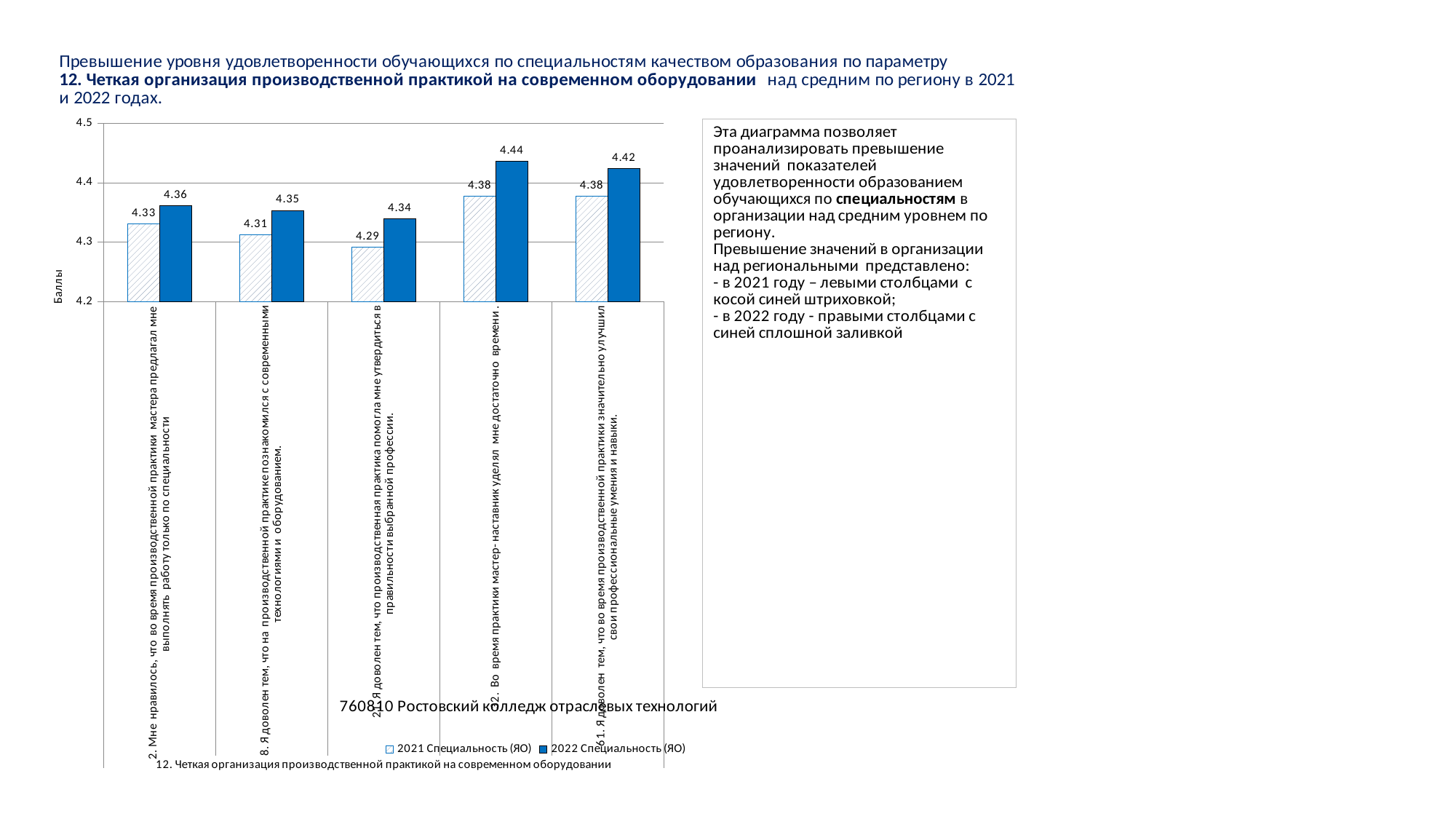
What is the 2022 Специальность (ЯО) value for statement 61 ("Я доволен тем, что во время производственной практики значительно улучшил свои профессиональные умения и навыки")? 4.42 What type of chart is shown on the slide? Bar chart Which statement has the lowest 2021 Специальность (ЯО) value? 21. Я доволен тем, что производственная практика помогла мне утвердиться в правильности выбранной профессии What is the 2021 Специальность (ЯО) value for statement 2 ("Мне нравилось, что во время производственной практики мастер предлагал мне выполнять работу только по специальности")? 4.33 What is the 2022 Специальность (ЯО) value for statement 32 ("Во время практики мастер-наставник уделял мне достаточно времени")? 4.44 Which statement has the highest 2022 Специальность (ЯО) value? 32. Во время практики мастер-наставник уделял мне достаточно времени For statement 8 ("Я доволен тем, что на производственной практике познакомился с современными технологиями и оборудованием"), which is larger: the 2021 value or the 2022 value? 2022 value (4.35) What is the label of the vertical axis of the chart? Баллы How many statements (categories) are shown on the x axis of the chart? 5 How many series does the chart legend list? 2 What is the difference between the 2022 and 2021 values for statement 32 ("Во время практики мастер-наставник уделял мне достаточно времени")? 0.06